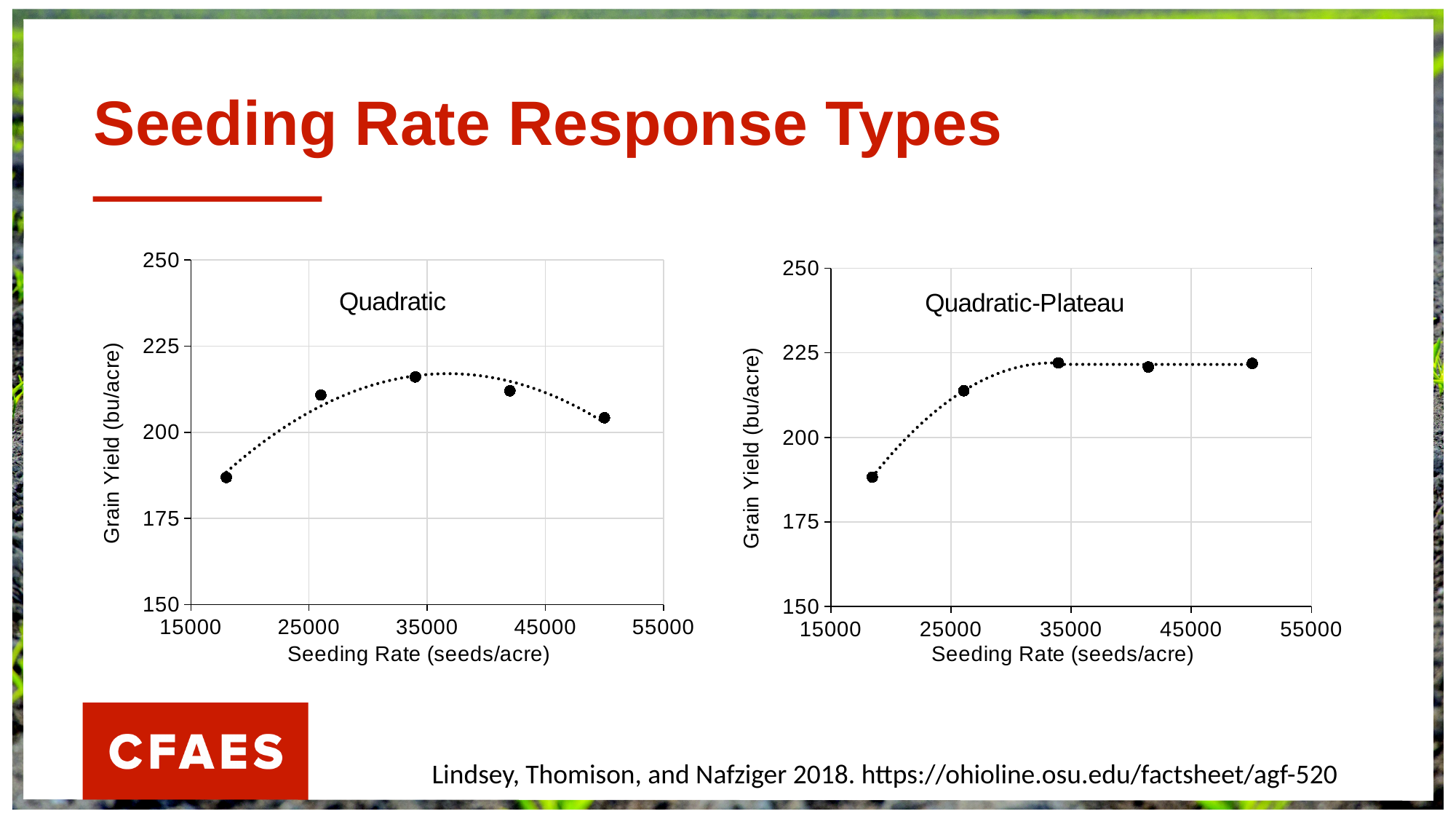
In the Quadratic chart, does grain yield rise or fall as seeding rate increases from about 34000 to 50000 seeds/acre? Fall In the Quadratic-Plateau chart, how many data points are plotted? 5 What is the label on the x axis of both charts? Seeding Rate (seeds/acre) What is the label on the y axis of both charts? Grain Yield (bu/acre) In the Quadratic chart, how many data points are plotted? 5 In the Quadratic chart, is the grain yield at the lowest seeding rate (around 18000 seeds/acre) greater or less than 200 bu/acre? less What kind of chart is the Quadratic chart? Scatter chart with a dotted trend line In the Quadratic chart, which plotted point has the lowest grain yield: the one at the lowest seeding rate or the one at the highest seeding rate? The one at the lowest seeding rate In the Quadratic-Plateau chart, is the grain yield at the highest seeding rate (around 50000 seeds/acre) greater or less than 225 bu/acre? less In the Quadratic-Plateau chart, does grain yield rise or fall as seeding rate increases from about 18000 to 34000 seeds/acre? Rise In the Quadratic-Plateau chart, is the grain yield at the lowest seeding rate (around 18000 seeds/acre) greater or less than 200 bu/acre? less